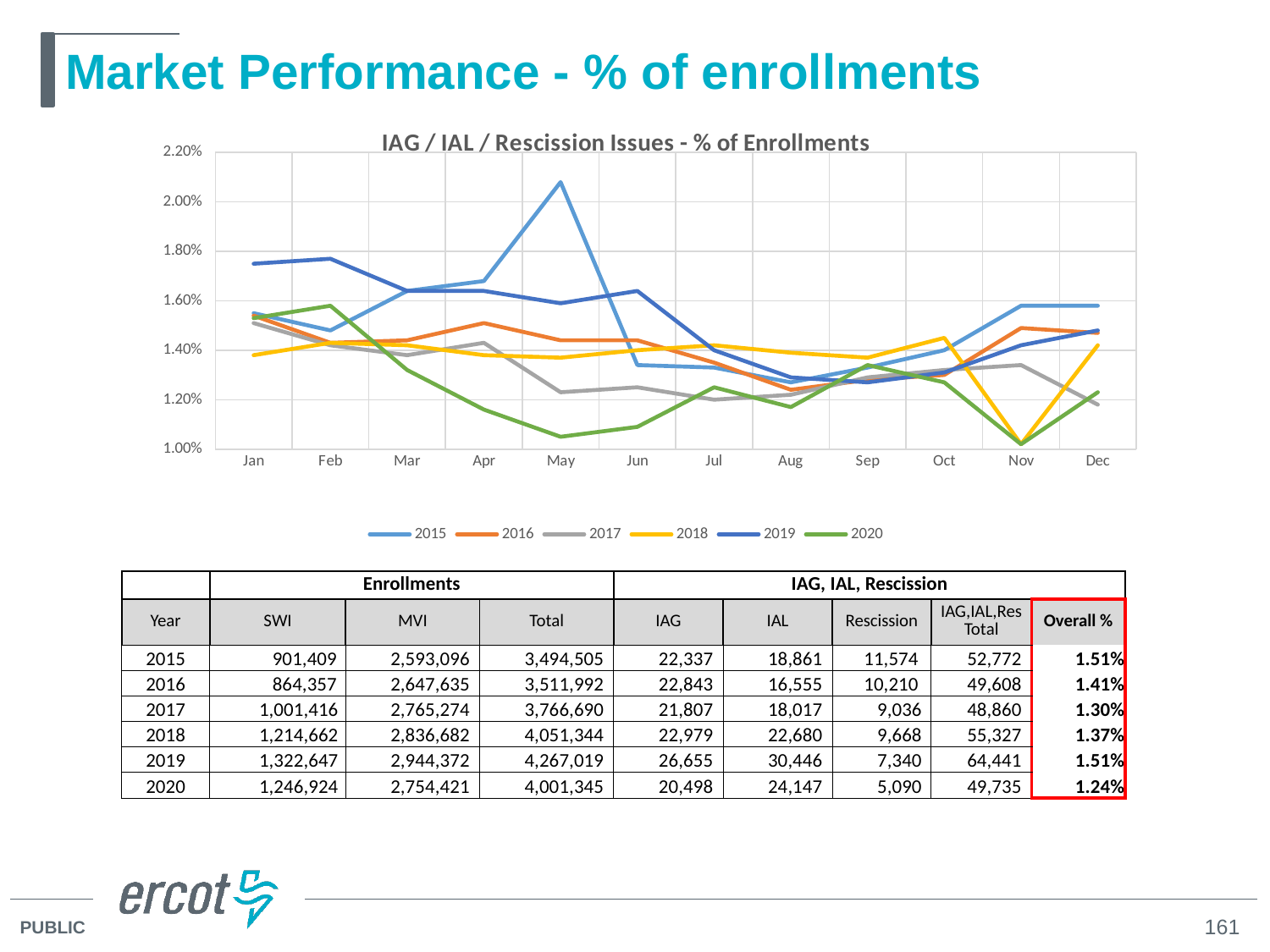
Is the value for 2015 in May greater or less than 2.00%? greater What is the title of the chart? IAG / IAL / Rescission Issues - % of Enrollments Is the value for 2019 in Jan greater or less than 1.60%? greater Is the value for 2018 in Nov greater or less than 1.20%? less Which series has the lowest value in May? 2020 How many months are shown along the x axis of the chart? 12 Which series has the highest value in May? 2015 In Jan, which series has the larger value, 2019 or 2020? 2019 What kind of chart is shown on the slide? line chart Does the 2015 line rise or fall from May to Jun? fall How many series does the chart legend list? 6